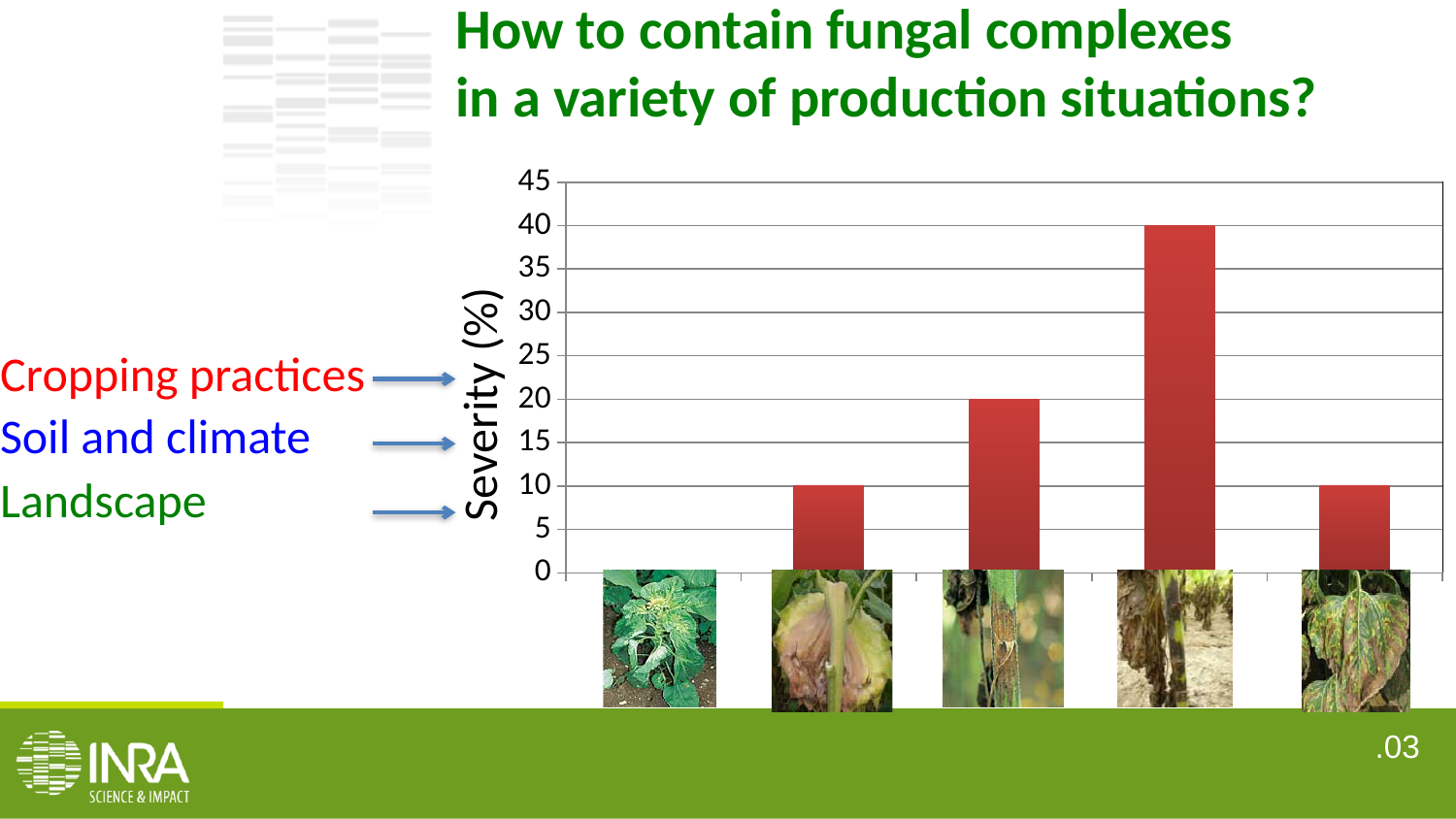
How many bars are visible in the chart? 4 What is the highest value shown on the vertical axis of the chart? 45 Which is taller, the third bar from the left or the second bar from the left? the third bar What kind of chart is shown on the slide? bar chart What is the severity value of the tallest bar in the chart? 40 What severity value does the rightmost bar reach? 10 What is the label of the vertical axis of the chart? Severity (%)